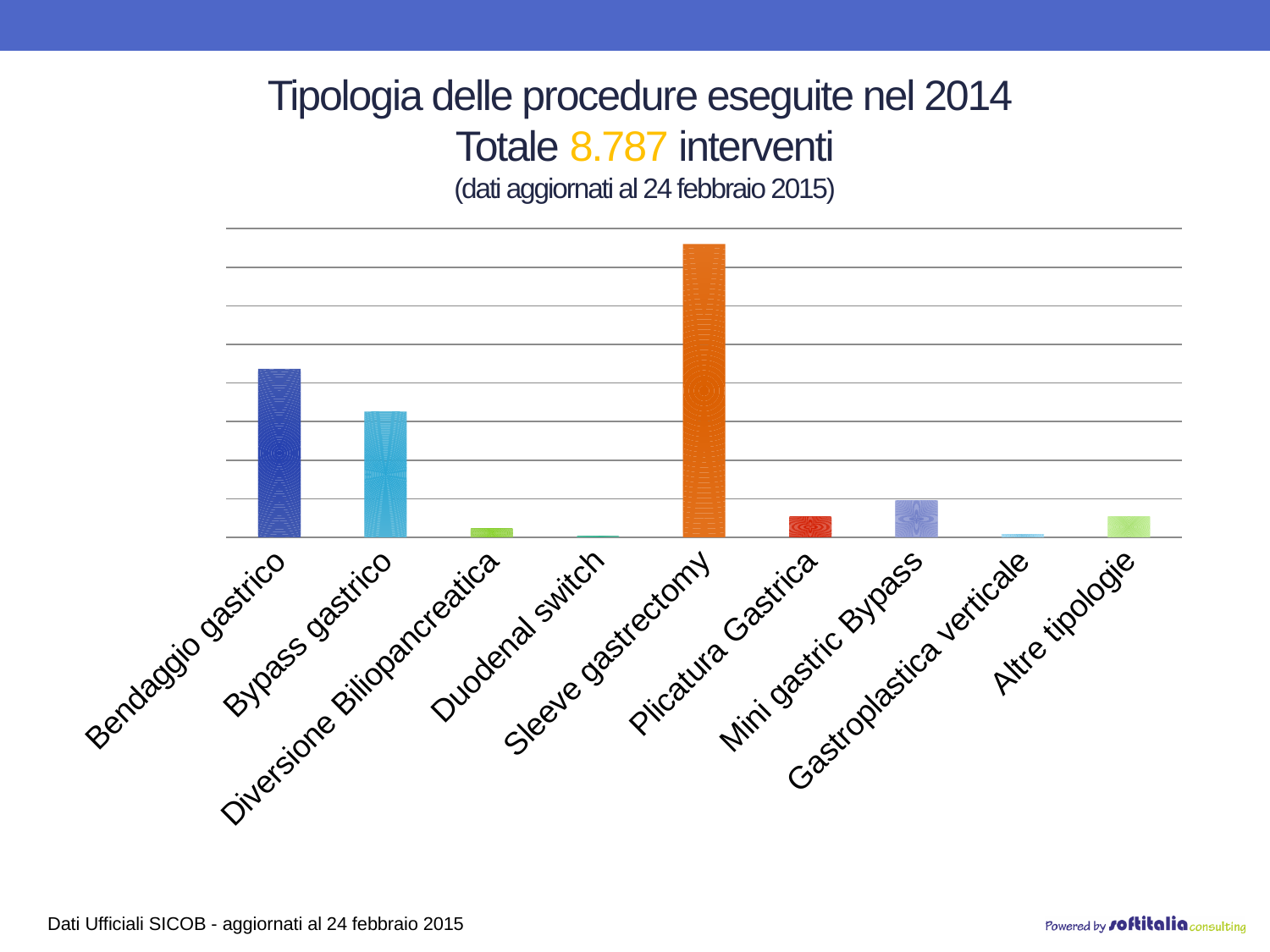
Which bar is taller, Sleeve gastrectomy or Bypass gastrico? Sleeve gastrectomy Which bar is taller, Mini gastric Bypass or Plicatura Gastrica? Mini gastric Bypass Which procedure has the highest bar in the chart? Sleeve gastrectomy How many procedure categories are shown on the x axis of the chart? 9 Which bar is taller, Altre tipologie or Diversione Biliopancreatica? Altre tipologie What is the title of the chart on the slide? Tipologia delle procedure eseguite nel 2014 Which procedure has the second highest bar in the chart? Bendaggio gastrico According to the slide title, what is the total number of interventi in 2014? 8.787 What kind of chart is shown on the slide? bar chart